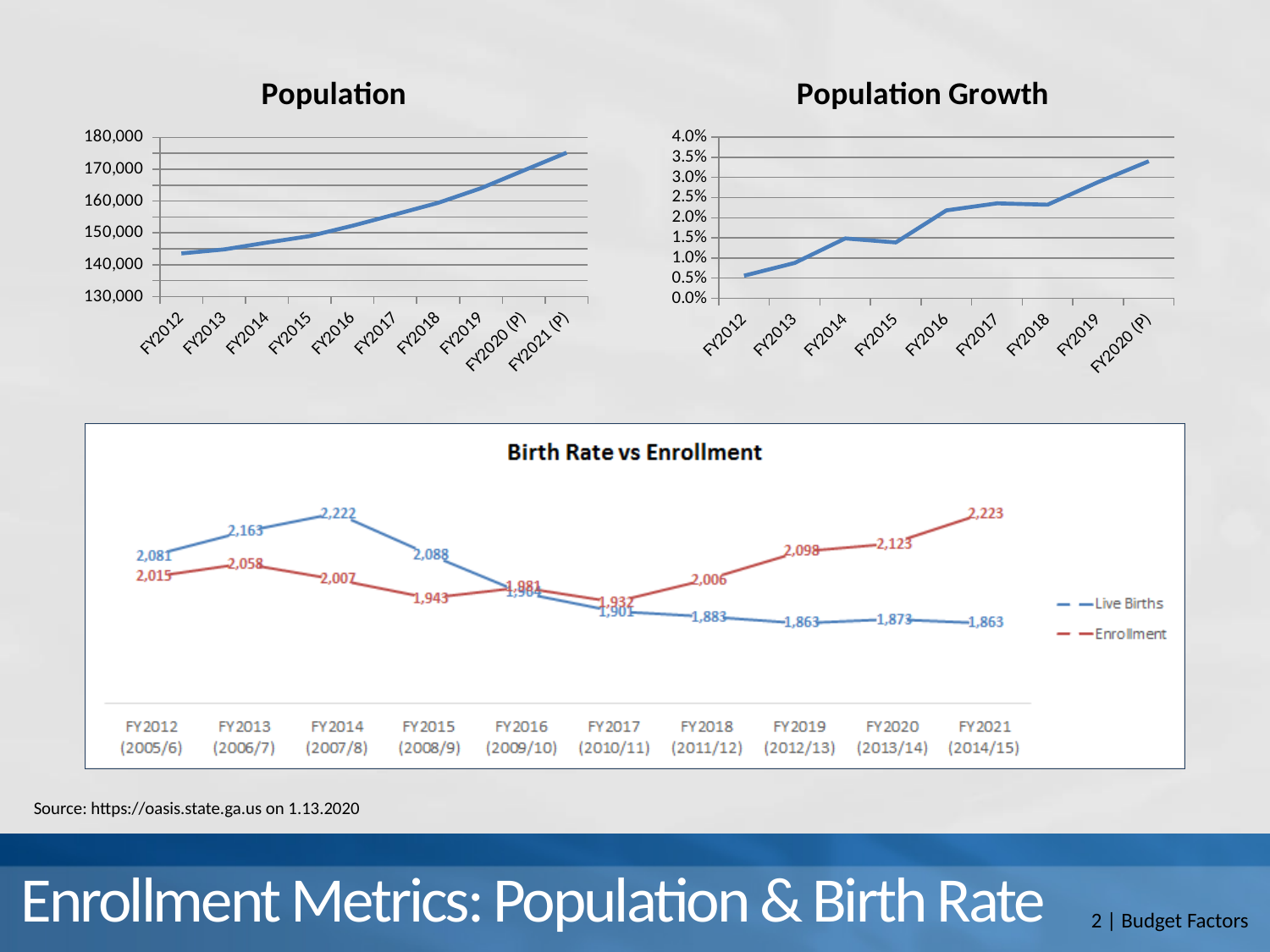
What kind of chart is the Population chart? Line chart On the Birth Rate vs Enrollment chart, what is the difference between Enrollment in FY2021 (2014/15) and FY2020 (2013/14)? 100 On the Population Growth chart, is the value for FY2012 greater or less than 1.0%? less On the Birth Rate vs Enrollment chart, what is the Enrollment value for FY2015 (2008/9)? 1,943 On the Birth Rate vs Enrollment chart, what is the Live Births value for FY2014 (2007/8)? 2,222 Do the values on the Population chart rise or fall from FY2012 to FY2021 (P)? rise How many series does the legend of the Birth Rate vs Enrollment chart list? 2 On the Population chart, is the value for FY2021 (P) greater or less than 170,000? greater How many fiscal years are plotted on the Population chart? 10 On the Birth Rate vs Enrollment chart, in which fiscal year is Enrollment highest? FY2021 (2014/15) On the Birth Rate vs Enrollment chart, which series has the larger value in FY2012 (2005/6), Live Births or Enrollment? Live Births How many fiscal years are plotted on the Population Growth chart? 9